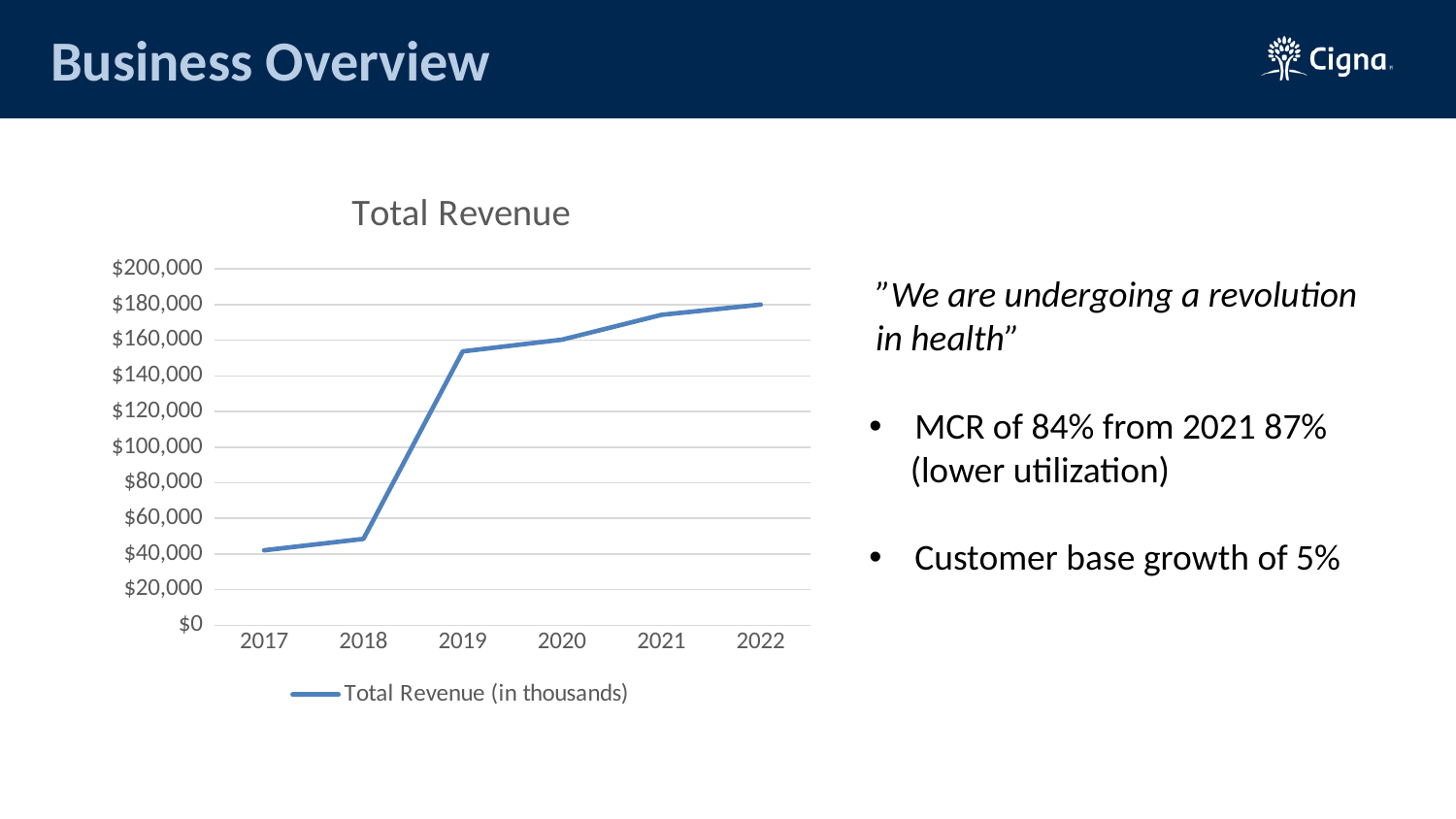
What is the title of the chart? Total Revenue Is the total revenue for 2017 greater or less than $60,000? less Which year has the larger total revenue, 2018 or 2019? 2019 How many series does the legend list? 1 How many years are plotted on the x axis? 6 What kind of chart is shown on the slide? line chart Do the total revenue values rise or fall from 2017 to 2022? rise Which year has the highest total revenue? 2022 Is the total revenue for 2019 greater or less than $140,000? greater What series name does the legend show? Total Revenue (in thousands) Which year has the lowest total revenue? 2017 Is the total revenue for 2022 greater or less than $160,000? greater